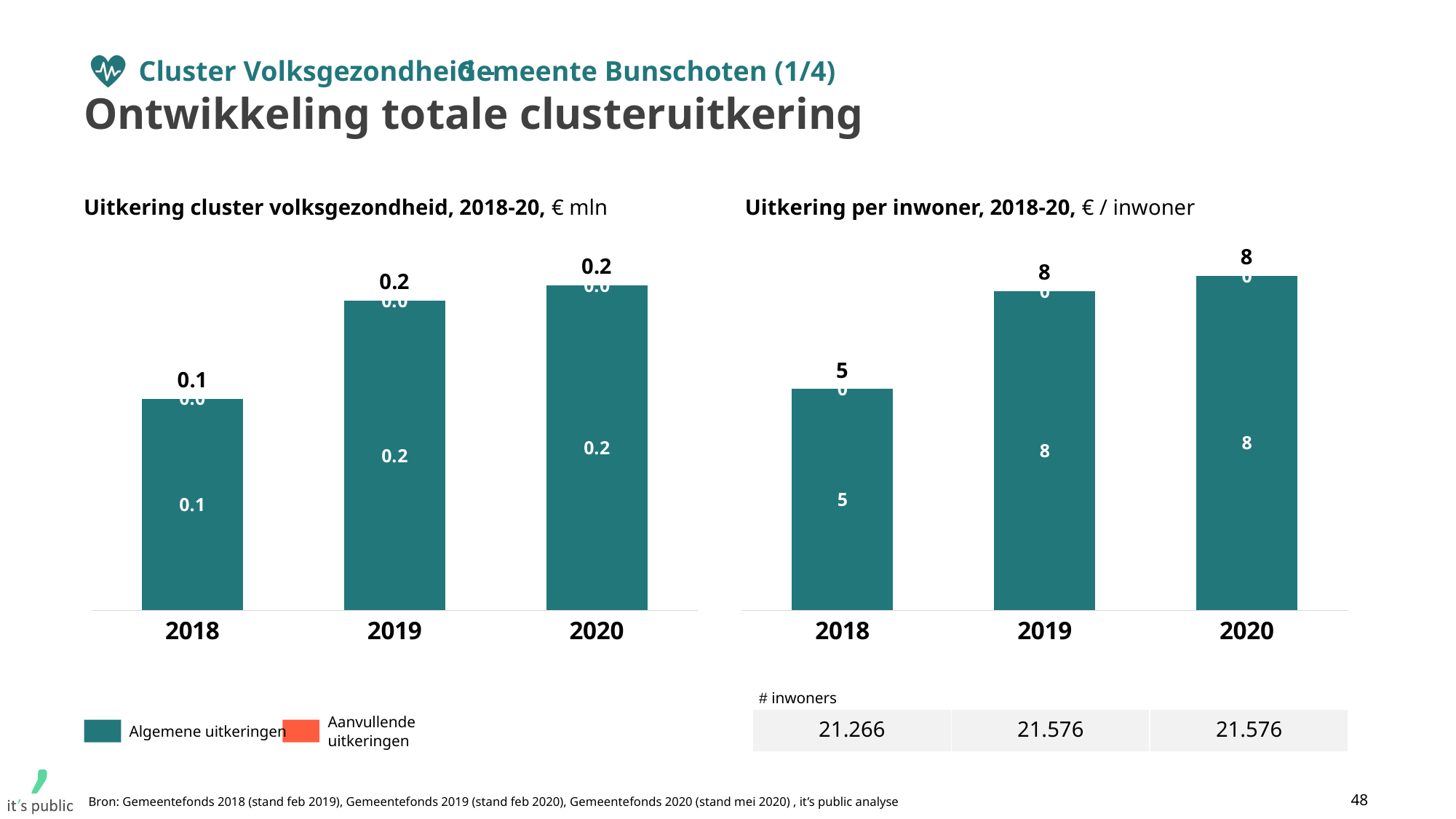
In the left chart 'Uitkering cluster volksgezondheid, 2018-20', what is the total value shown above the bar for 2020? 0.2 In the right chart 'Uitkering per inwoner, 2018-20', is the value for 2020 larger or smaller than the value for 2018? larger In the left chart 'Uitkering cluster volksgezondheid, 2018-20', which year has the lowest total? 2018 What kind of chart is the right chart 'Uitkering per inwoner, 2018-20'? bar chart In the right chart 'Uitkering per inwoner, 2018-20', what is the value for 2019? 8 In the right chart 'Uitkering per inwoner, 2018-20', what is the value for 2018? 5 In the right chart 'Uitkering per inwoner, 2018-20', what is the difference between the values for 2019 and 2018? 3 In the left chart 'Uitkering cluster volksgezondheid, 2018-20', what is the total value shown above the bar for 2018? 0.1 How many series does the legend below the left chart list? 2 In the right chart 'Uitkering per inwoner, 2018-20', which year has the lowest value? 2018 In the right chart 'Uitkering per inwoner, 2018-20', do the values rise or fall from 2018 to 2019? rise How many years are shown on the x axis of the left chart 'Uitkering cluster volksgezondheid, 2018-20'? 3